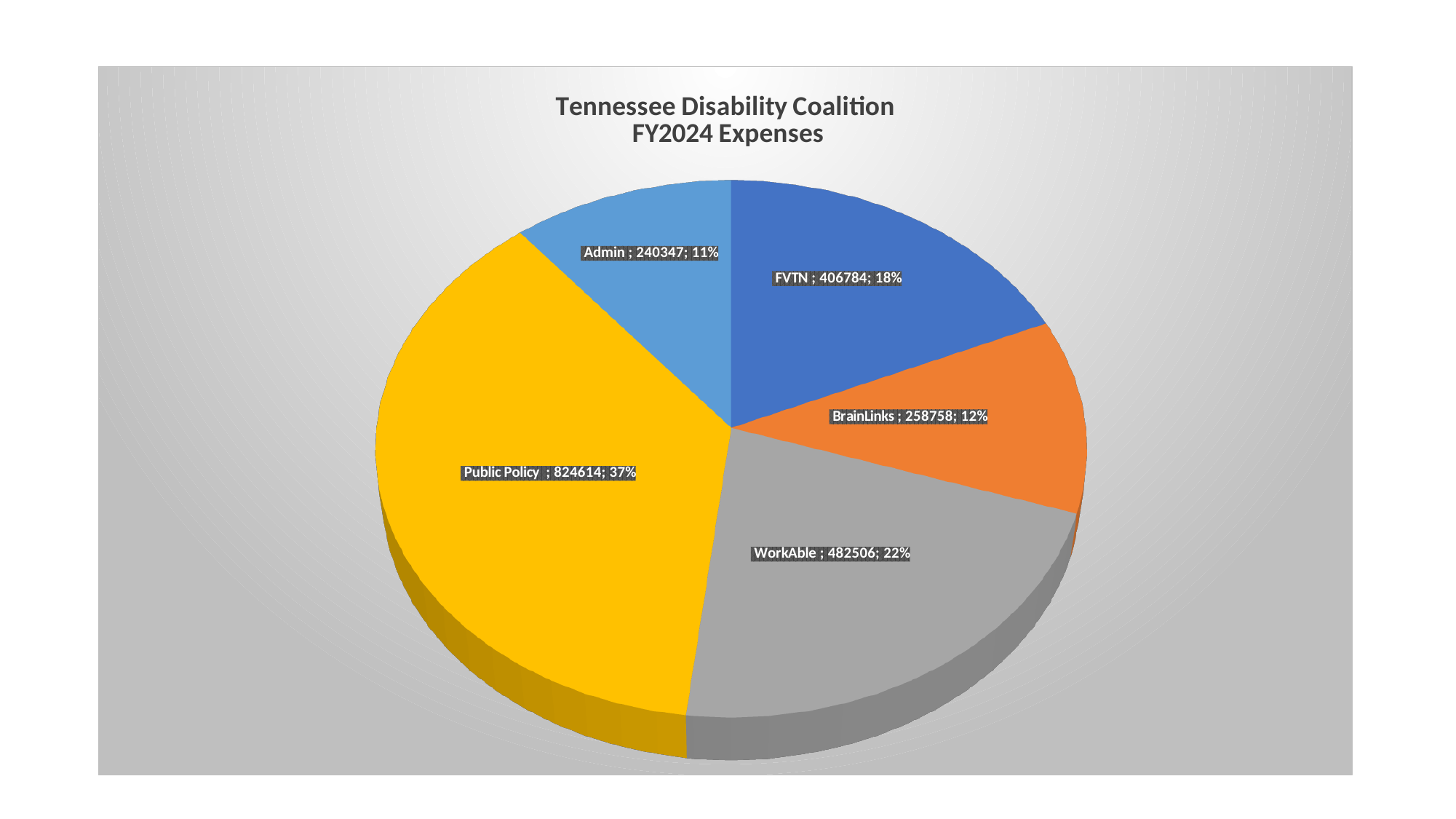
What type of chart is shown on the slide? Pie chart How many categories are shown in the pie chart? 5 Which category has the smallest expense? Admin What is the expense value for Admin? 240347 What percentage share of expenses does Public Policy represent? 37% What is the expense value for WorkAble? 482506 What is the difference between the WorkAble and FVTN expense values? 75722 What percentage share of expenses does BrainLinks represent? 12% What is the expense value for Public Policy? 824614 Which category has the largest expense? Public Policy Which is larger, the expense for BrainLinks or the expense for Admin? BrainLinks What is the expense value for FVTN? 406784